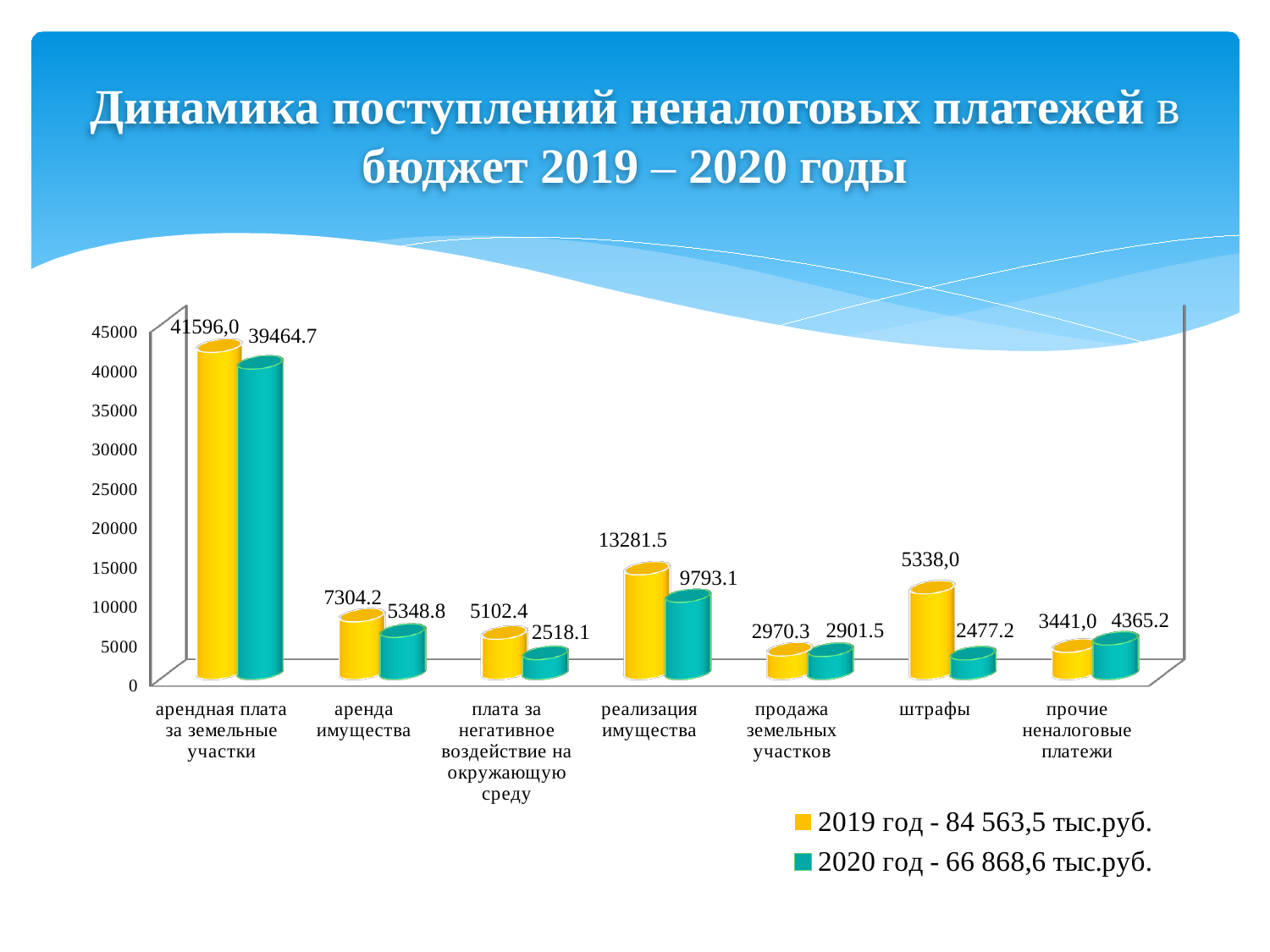
Which is larger for аренда имущества: the 2019 value or the 2020 value? 2019 How many series does the legend list? 2 What is the difference between the 2019 and 2020 values for штрафы? 2860.8 Which category has the highest 2019 value? арендная плата за земельные участки What is the 2019 value for штрафы? 5338,0 How many categories are shown on the x axis? 7 What is the 2020 value for плата за негативное воздействие на окружающую среду? 2518.1 Which category has the lowest 2020 value? штрафы Is the 2019 value for реализация имущества greater or less than 10000? greater What kind of chart is shown on the slide? bar chart What is the difference between the 2020 and 2019 values for прочие неналоговые платежи? 924.2 What is the 2020 value for реализация имущества? 9793.1